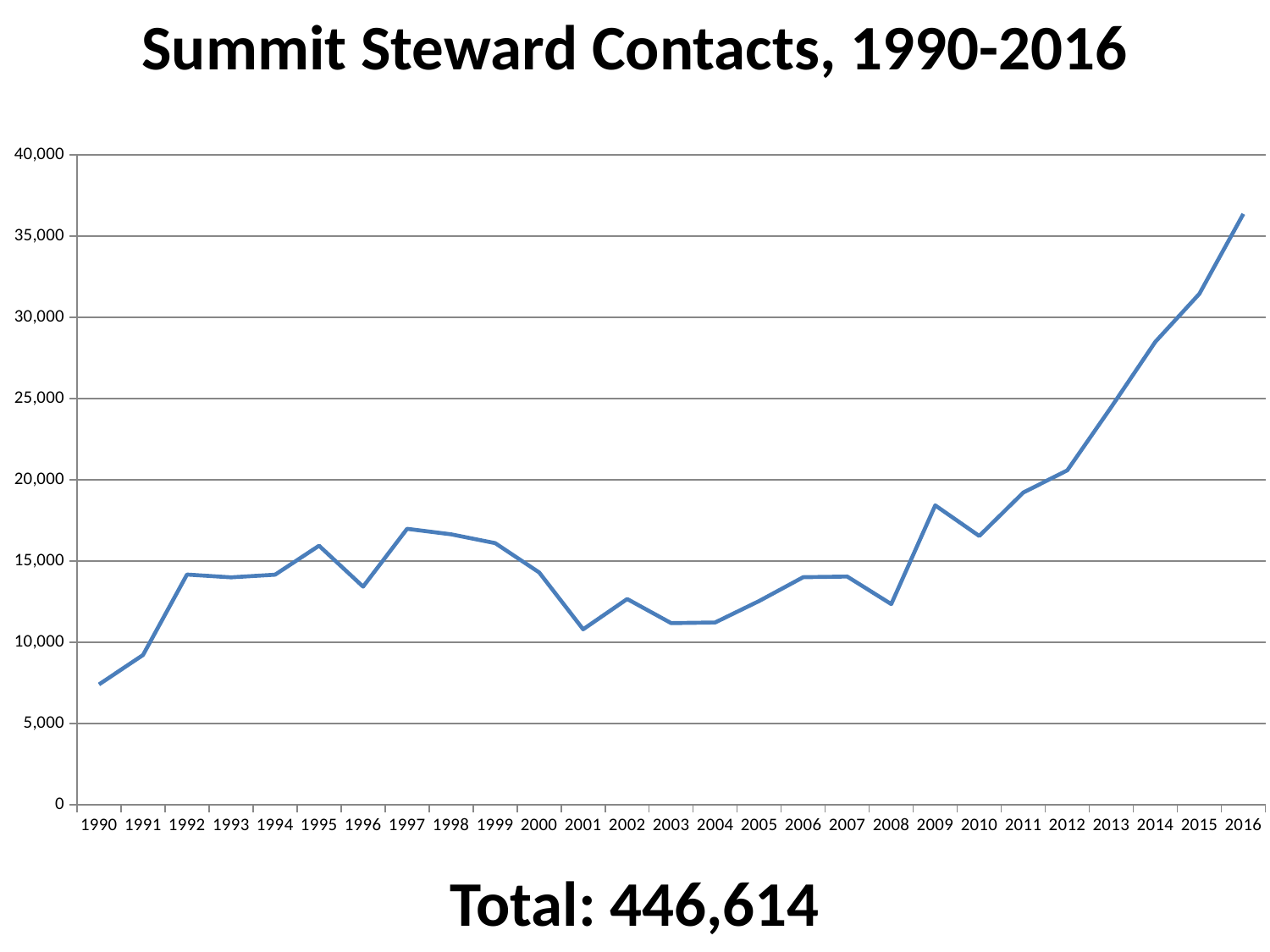
How many years are plotted along the x axis? 27 What total is printed below the chart? 446,614 Which year has the highest number of summit steward contacts? 2016 Which year has the lowest number of summit steward contacts? 1990 Is the value for 2009 greater or less than 20,000? less Is the value for 2016 greater or less than 35,000? greater Overall, do summit steward contacts rise or fall from 1990 to 2016? rise Is the value for 1990 greater or less than 10,000? less Which year has more contacts, 2009 or 2010? 2009 What kind of chart is shown on the slide? line chart What is the title of the chart? Summit Steward Contacts, 1990-2016